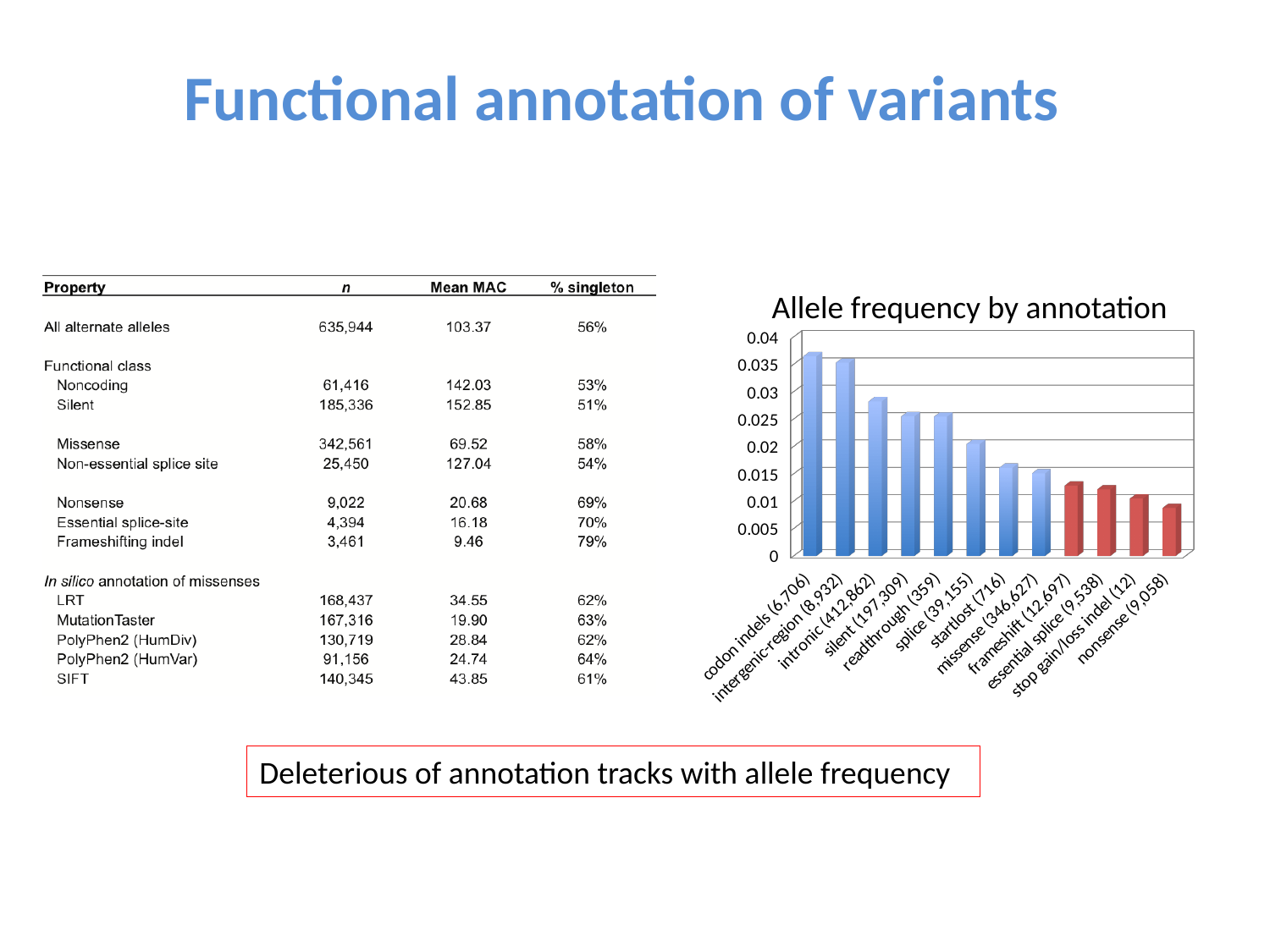
Which annotation category has the lowest allele frequency in the chart? nonsense (9,058) Which has the higher allele frequency, intronic (412,862) or silent (197,309)? intronic (412,862) Is the value for nonsense (9,058) greater or less than 0.015? less Which has the higher allele frequency, splice (39,155) or startlost (716)? splice (39,155) Is the value for intronic (412,862) greater or less than 0.025? greater Is the value for missense (346,627) greater or less than 0.02? less What is the title of the chart on the slide? Allele frequency by annotation How many annotation categories are plotted in the "Allele frequency by annotation" chart? 12 What kind of chart is the "Allele frequency by annotation" chart? bar chart Which annotation category has the highest allele frequency in the chart? codon indels (6,706) Do the bar values rise or fall from left to right along the x axis of the chart? fall